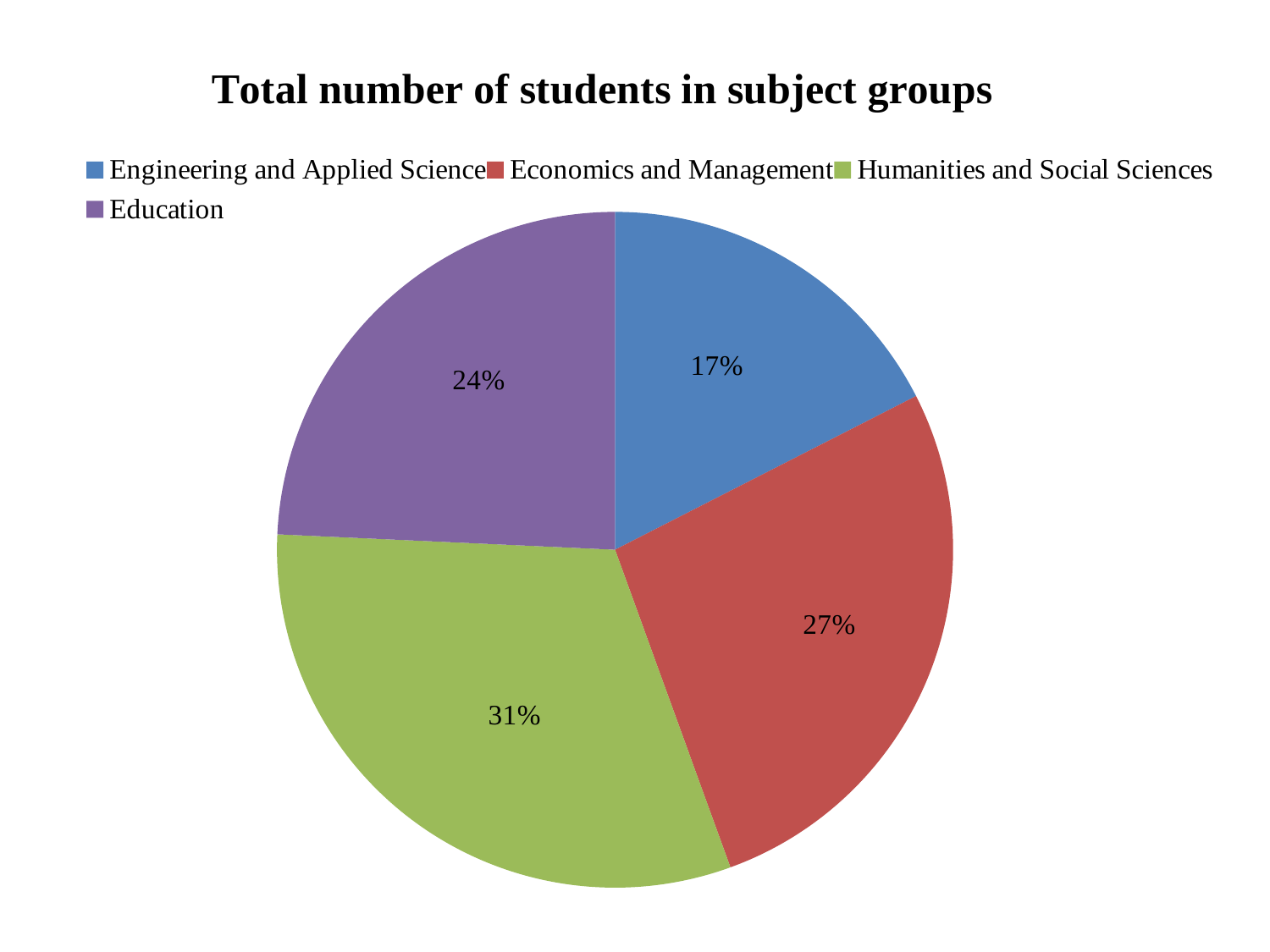
Which colour represents Education in the legend? purple What share of the pie does Engineering and Applied Science have? 17% What share of the pie does Education have? 24% What is the difference in percentage points between Humanities and Social Sciences and Engineering and Applied Science? 14 How many subject groups are shown in the pie chart? 4 Which has a larger share, Economics and Management or Education? Economics and Management What is the title of the chart? Total number of students in subject groups Which subject group has the largest share of the pie? Humanities and Social Sciences What kind of chart is shown on the slide? pie chart Which subject group has the smallest share of the pie? Engineering and Applied Science What share of the pie does Economics and Management have? 27%